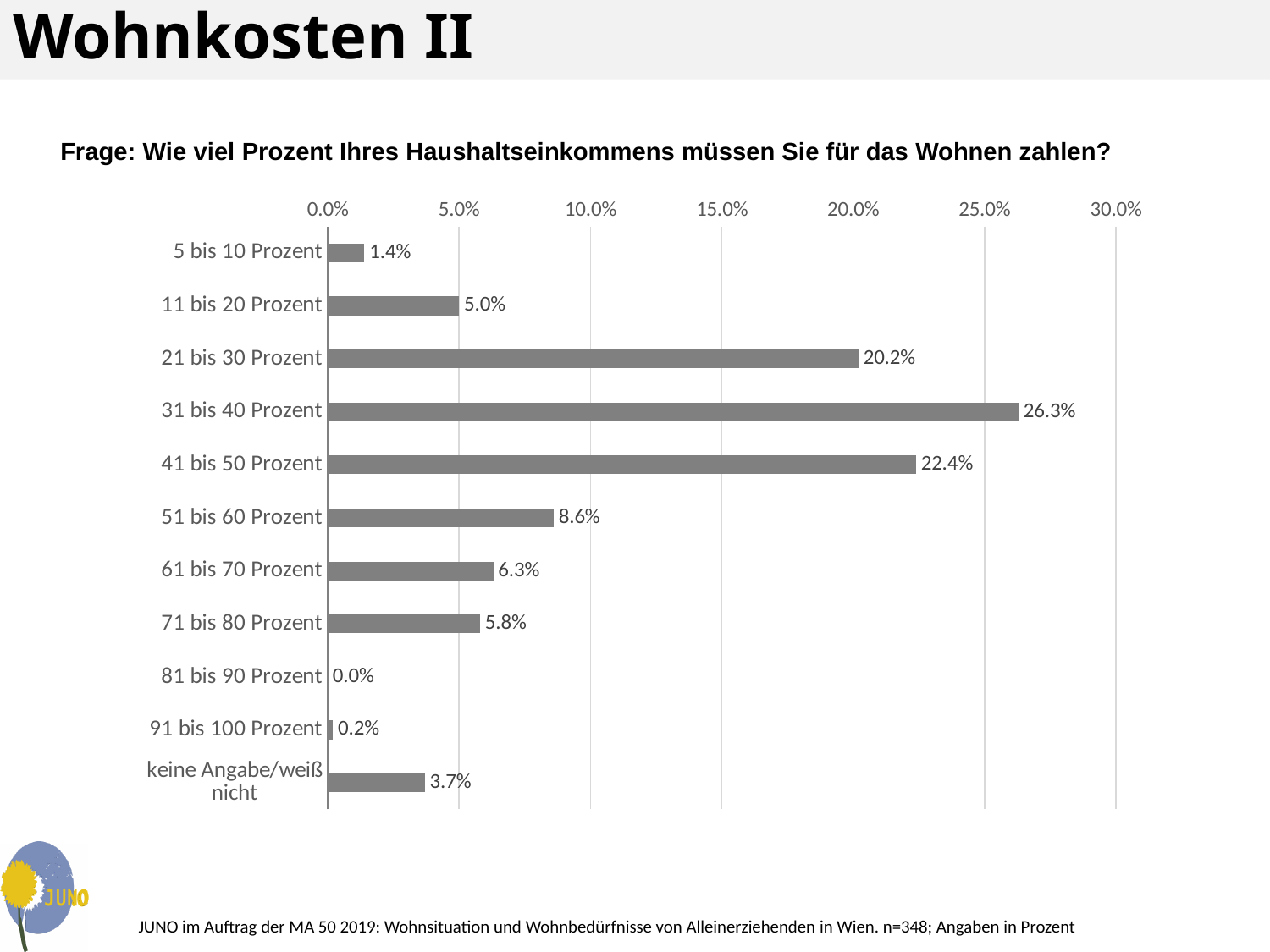
What is the value for "keine Angabe/weiß nicht"? 3.7% Which category has the highest value? 31 bis 40 Prozent Which is larger, the value for "11 bis 20 Prozent" or the value for "71 bis 80 Prozent"? 11 bis 20 Prozent How many categories are shown in the chart? 11 What is the difference between the values for "31 bis 40 Prozent" and "41 bis 50 Prozent"? 3.9% What is the value for "21 bis 30 Prozent"? 20.2% What is the highest value shown on the x axis? 30.0% What kind of chart is shown on the slide? bar chart Is the value for "41 bis 50 Prozent" greater or less than 20.0%? greater What is the value for "31 bis 40 Prozent"? 26.3% What is the difference between the values for "51 bis 60 Prozent" and "61 bis 70 Prozent"? 2.3% Which category has the lowest value? 81 bis 90 Prozent